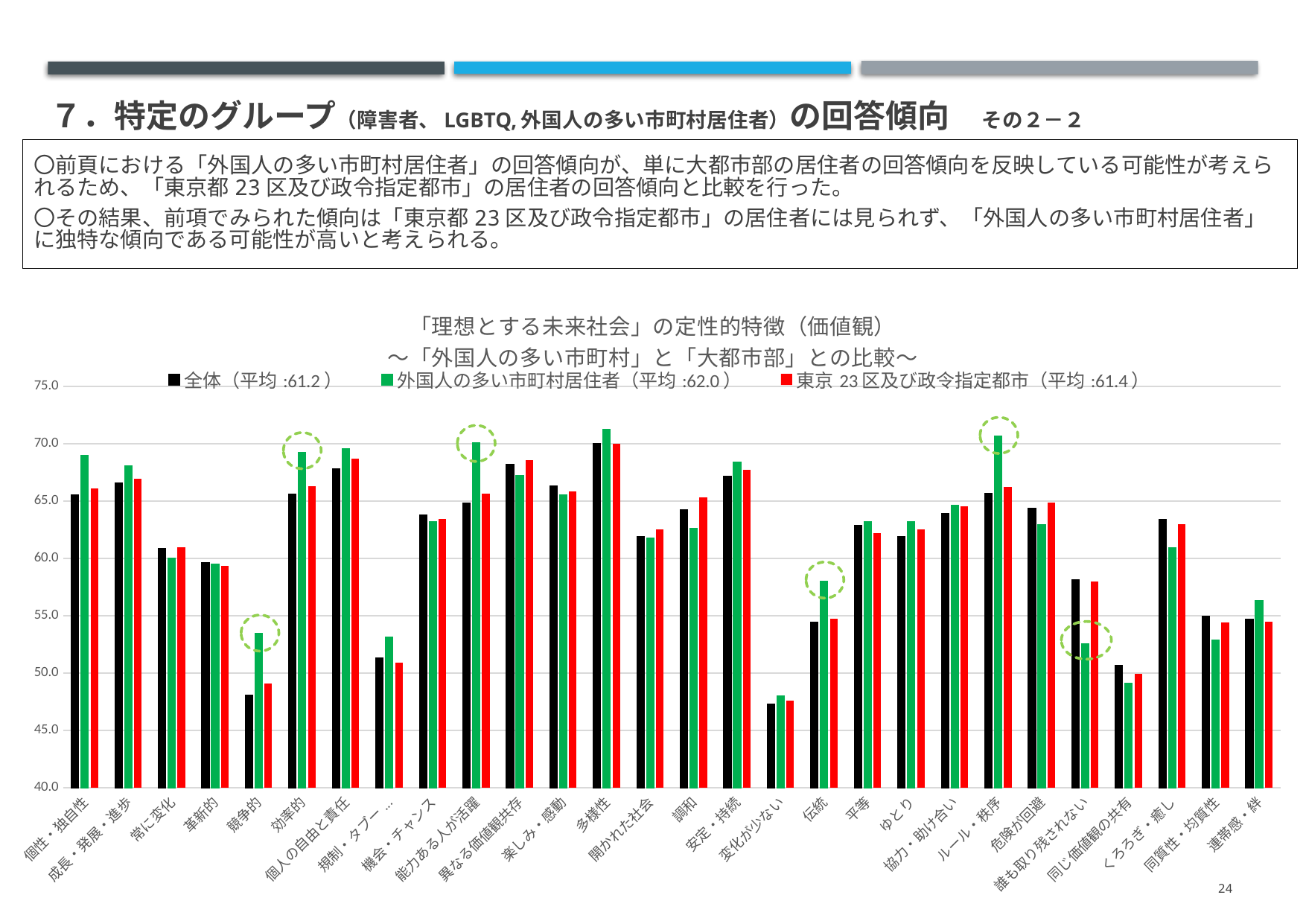
How many categories are plotted along the x axis of the chart? 28 For 誰も取り残されない, which series has the larger value: 外国人の多い市町村居住者 or 東京23区及び政令指定都市? 東京23区及び政令指定都市 For 伝統, which series has the larger value: 外国人の多い市町村居住者 or 東京23区及び政令指定都市? 外国人の多い市町村居住者 Which category has the highest value for the 全体 series? 多様性 Which category has the lowest value for the 全体 series? 変化が少ない How many series does the chart legend list? 3 According to the legend, what is the average (平均) for the 外国人の多い市町村居住者 series? 62.0 Is the value for 変化が少ない in the 全体 series greater or less than 50.0? less Is the value for 多様性 in the 外国人の多い市町村居住者 series greater or less than 70.0? greater Is the value for 競争的 in the 外国人の多い市町村居住者 series greater or less than 50.0? greater What kind of chart is shown on the slide? bar chart According to the legend, what is the average (平均) for the 全体 series? 61.2